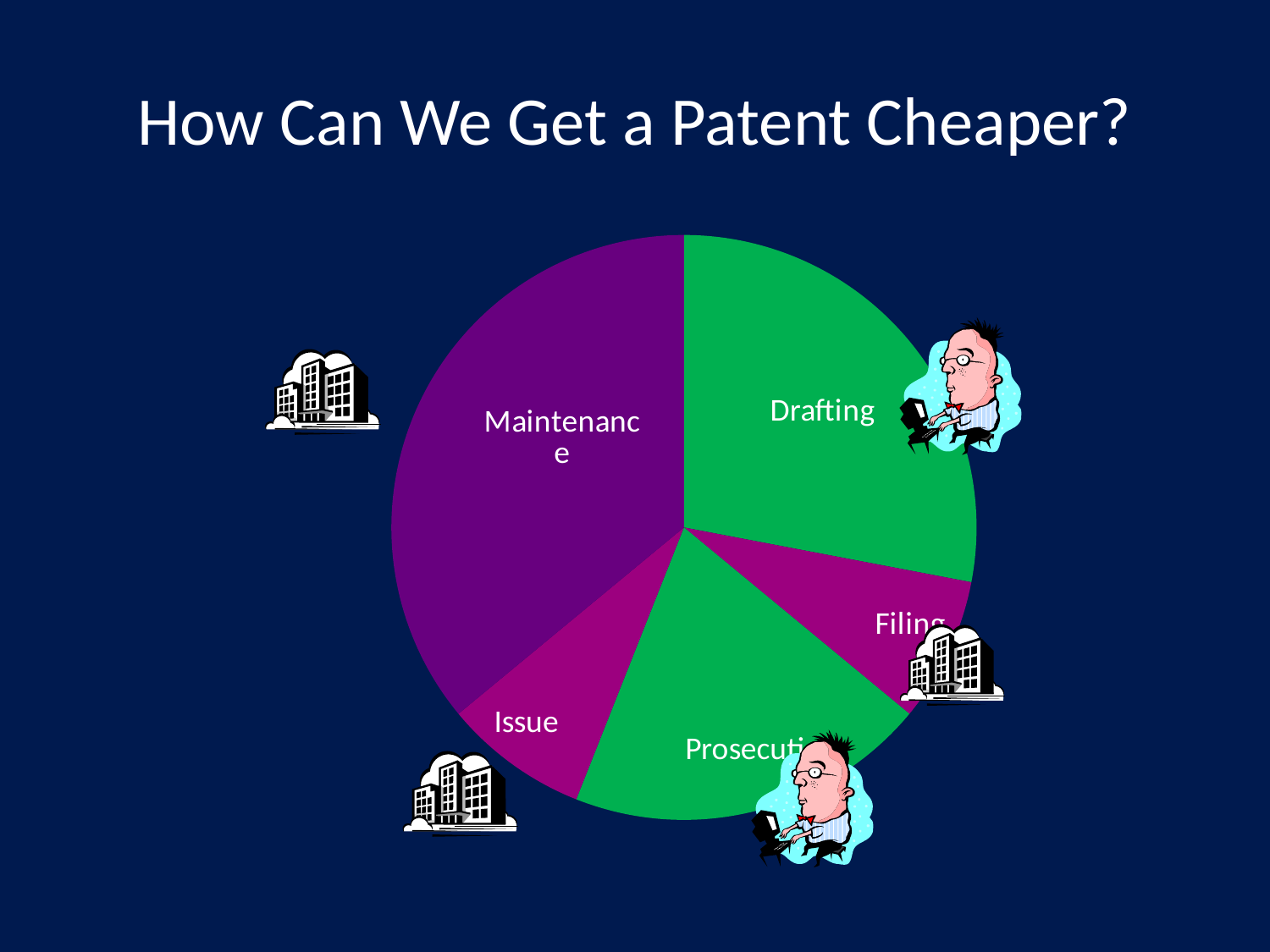
What kind of chart is shown on the slide? pie chart How many slices does the pie chart have? 5 Which slice of the pie chart is the largest? Maintenance Which is larger in the pie chart, Maintenance or Issue? Maintenance What is the title of the slide containing the pie chart? How Can We Get a Patent Cheaper? Which is larger in the pie chart, Prosecution or Filing? Prosecution What colour is the Drafting slice of the pie chart? green Which is larger in the pie chart, Drafting or Prosecution? Drafting